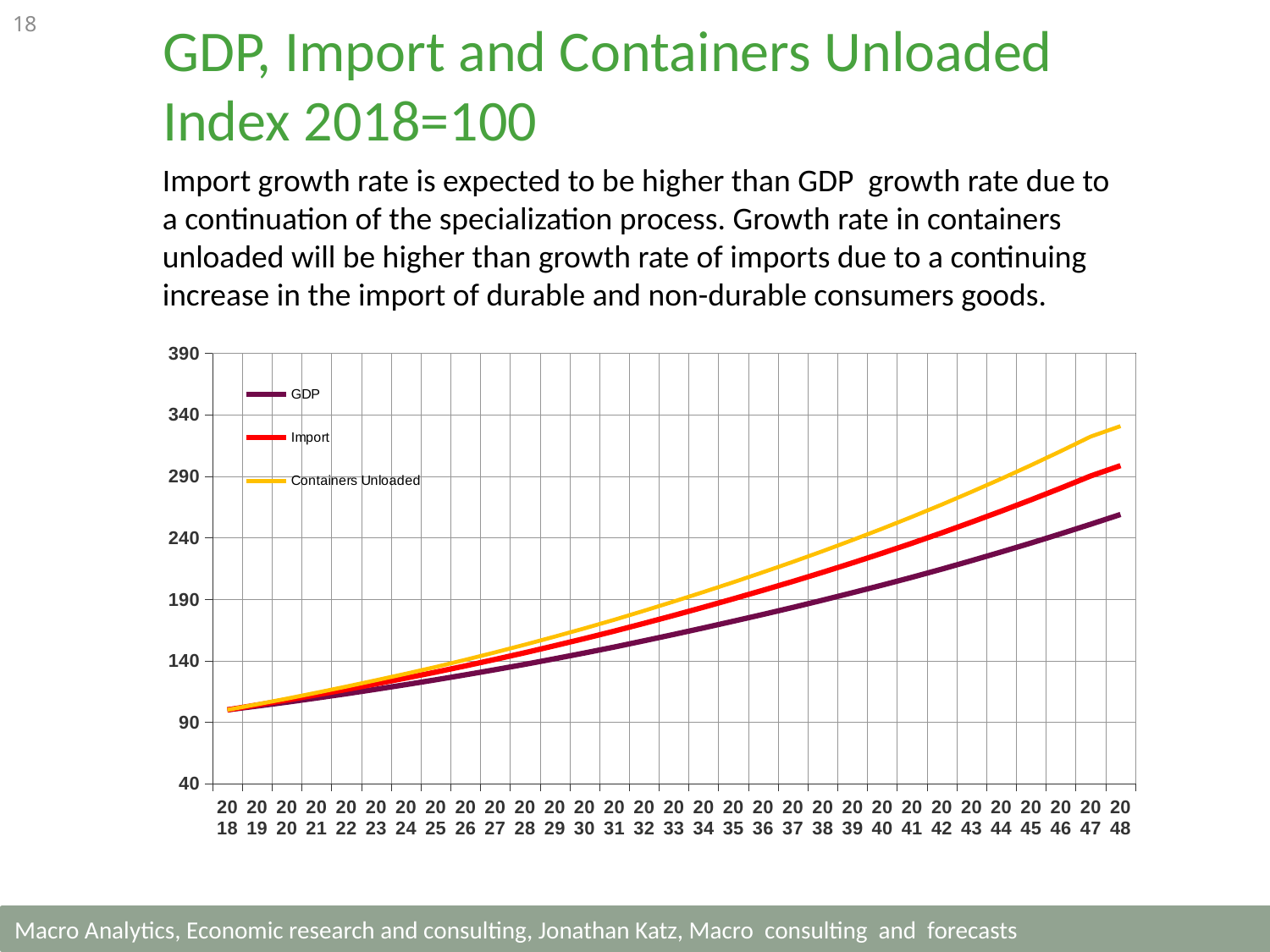
What kind of chart is shown on the slide? line chart How many years are shown along the x axis of the chart? 31 In 2048, is the value for Containers Unloaded greater or less than 290? greater How many series does the chart's legend list? 3 Do the values of the Containers Unloaded series rise or fall from 2018 to 2048? rise In 2048, is the value for GDP greater or less than 290? less What is the last year shown on the x axis of the chart? 2048 Which series has the highest value in 2048? Containers Unloaded What is the first year shown on the x axis of the chart? 2018 What colour is the Import line in the chart? red Which series has the lowest value in 2048? GDP Which series are listed in the chart's legend? GDP, Import, Containers Unloaded